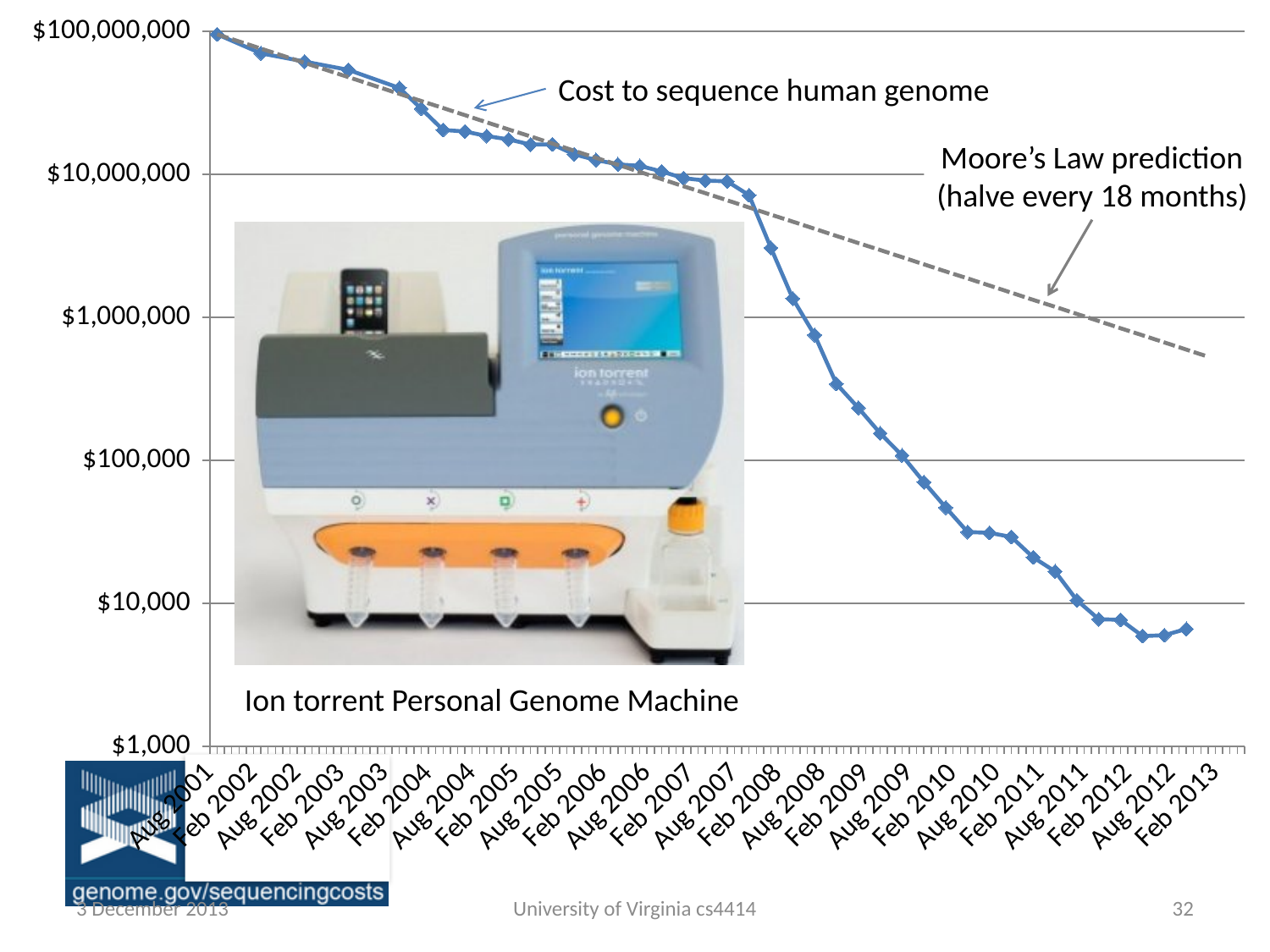
What kind of chart is shown on the slide? line chart Which is higher: the cost to sequence a human genome in Aug 2001 or in Feb 2013? Aug 2001 Is the cost to sequence a human genome in Feb 2004 greater or less than $10,000,000? greater Is the cost to sequence a human genome in Feb 2009 greater or less than $100,000? greater At Feb 2013, which is higher: the Moore's Law prediction or the actual cost to sequence a human genome? Moore's Law prediction Is the cost to sequence a human genome in Aug 2010 greater or less than $100,000? less According to the slide, how often does the Moore's Law prediction halve the cost? every 18 months How many lines are plotted on the chart? 2 Does the cost to sequence a human genome rise or fall from Aug 2001 to Feb 2013? fall What is the highest value labelled on the y axis? $100,000,000 What is the first date labelled on the x axis? Aug 2001